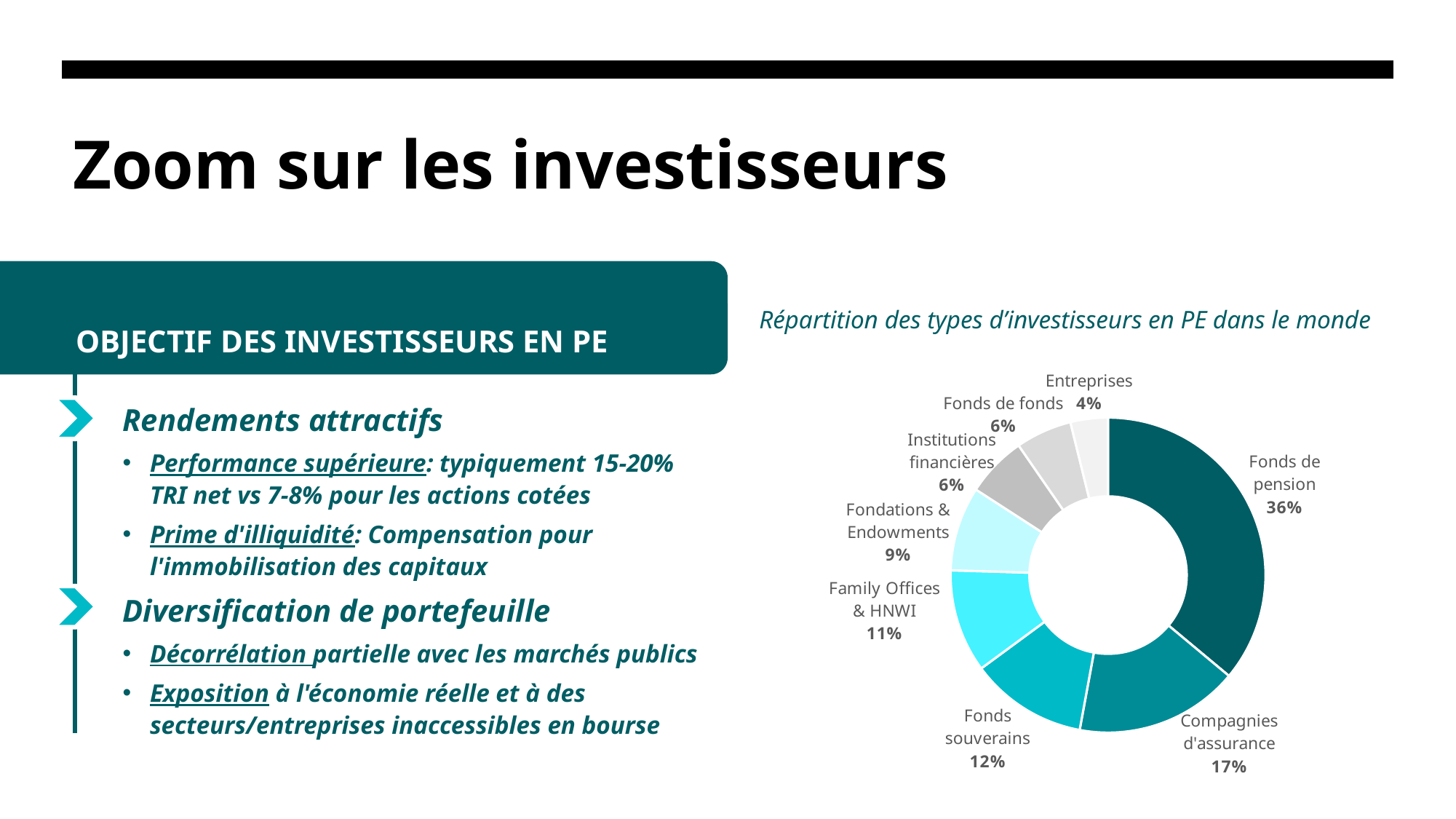
What is the title of the chart on the slide? Répartition des types d'investisseurs en PE dans le monde Which investor type has the largest share in the pie chart? Fonds de pension What share of the pie chart is Fonds de pension? 36% What kind of chart is shown on the slide? Pie chart (doughnut) What share of the pie chart is Entreprises? 4% What is the difference in percentage points between Fonds de pension and Compagnies d'assurance? 19 Which investor type has the smallest share in the pie chart? Entreprises How many investor categories are shown in the pie chart? 8 Which has a larger share, Fonds souverains or Fondations & Endowments? Fonds souverains What share of the pie chart is Family Offices & HNWI? 11% What is the combined share of Fonds de fonds and Institutions financières? 12% What share of the pie chart is Compagnies d'assurance? 17%